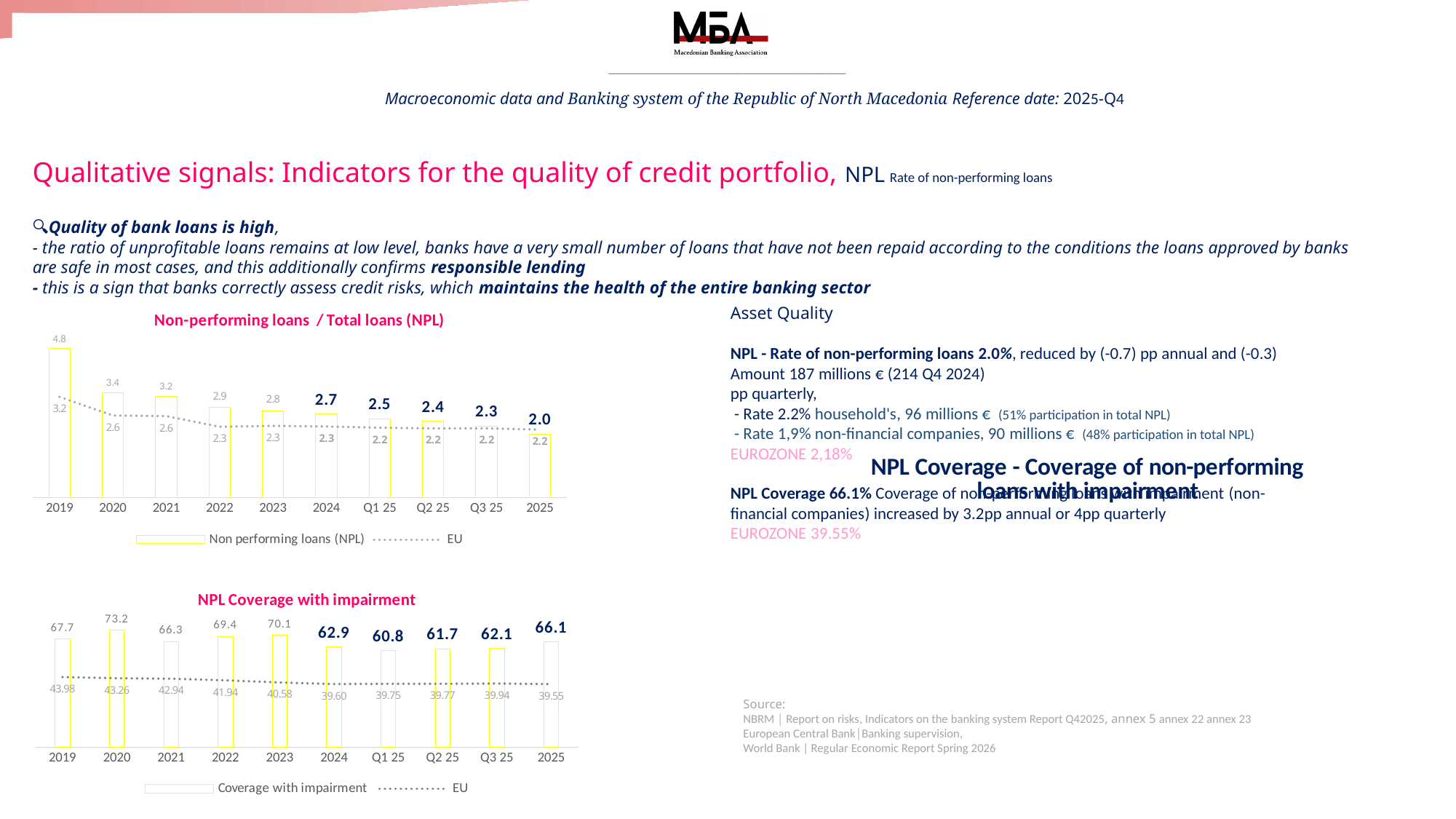
In the 'Non-performing loans / Total loans (NPL)' chart, what is the EU value for 2019? 3.2 In the 'Non-performing loans / Total loans (NPL)' chart, does the NPL series rise or fall from 2019 to 2025? fall In the 'Non-performing loans / Total loans (NPL)' chart, what is the difference between the NPL values for 2019 and 2020? 1.4 In the 'Non-performing loans / Total loans (NPL)' chart, what is the NPL value for 2025? 2.0 In the 'Non-performing loans / Total loans (NPL)' chart, how many series does the legend list? 2 In the 'NPL Coverage with impairment' chart, how many periods are shown on the x axis? 10 In the 'NPL Coverage with impairment' chart, which period has the lowest coverage value? Q1 25 What type of chart is the 'NPL Coverage with impairment' chart? bar chart with a line In the 'NPL Coverage with impairment' chart, what is the coverage value for 2020? 73.2 In the 'NPL Coverage with impairment' chart, which is larger: the coverage value for 2024 or for 2025? 2025 In the 'NPL Coverage with impairment' chart, what is the EU value for 2025? 39.55 In the 'Non-performing loans / Total loans (NPL)' chart, which year has the highest NPL value? 2019